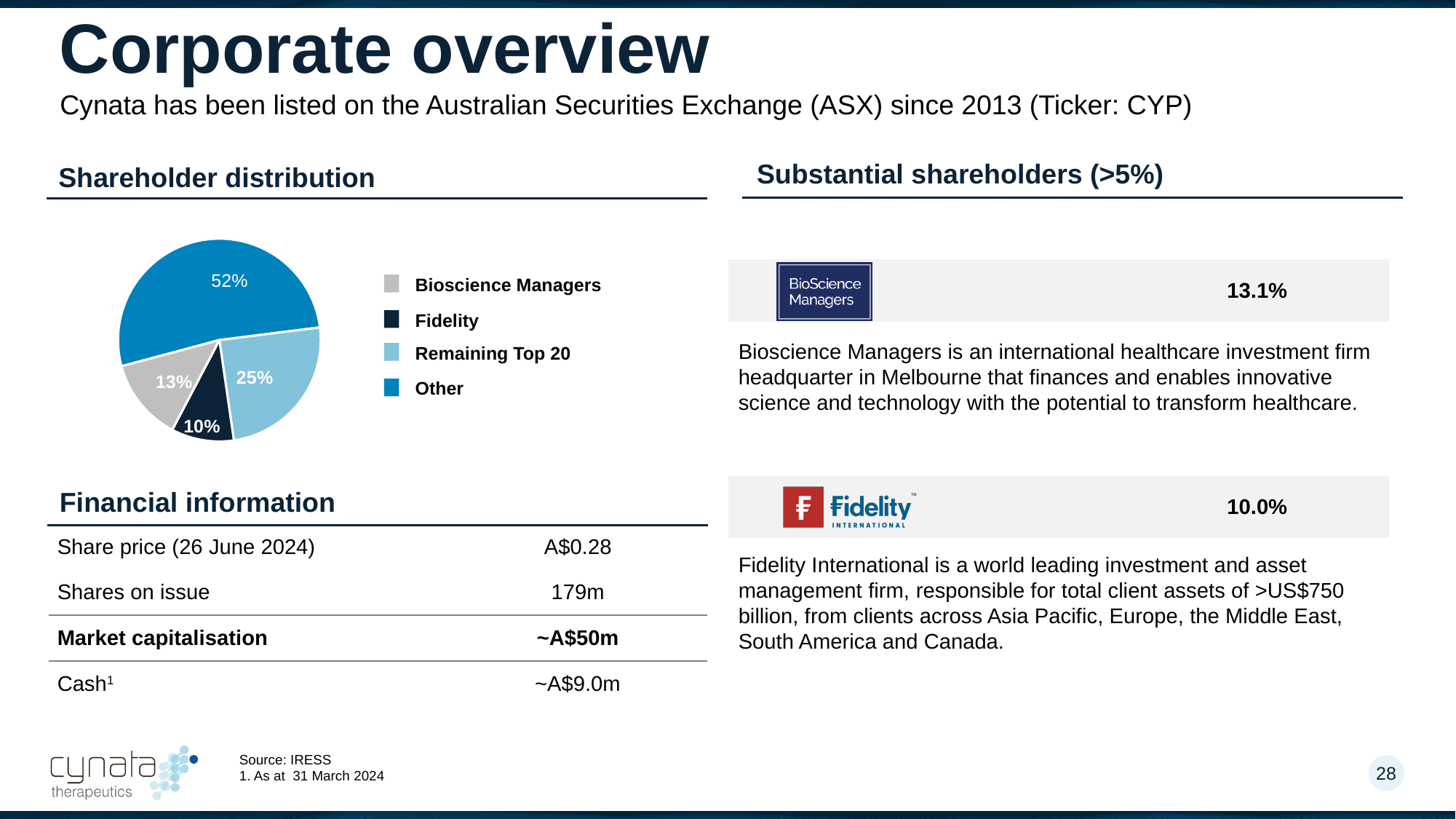
Which slice of the Shareholder distribution pie chart is the largest? Other How many slices does the Shareholder distribution pie chart have? 4 In the Shareholder distribution pie chart, what share is held by Remaining Top 20? 25% What kind of chart is shown under "Shareholder distribution"? Pie chart In the Shareholder distribution pie chart, which is larger: Bioscience Managers or Fidelity? Bioscience Managers In the Shareholder distribution pie chart, what share is held by Bioscience Managers? 13% In the Shareholder distribution pie chart, what share is held by Other? 52% In the Shareholder distribution pie chart, what colour is the Fidelity slice? Dark navy blue In the Shareholder distribution pie chart, what is the difference in percentage points between Other and Remaining Top 20? 27 percentage points How many entries does the legend of the Shareholder distribution pie chart list? 4 In the Shareholder distribution pie chart, what share is held by Fidelity? 10% Which slice of the Shareholder distribution pie chart is the smallest? Fidelity